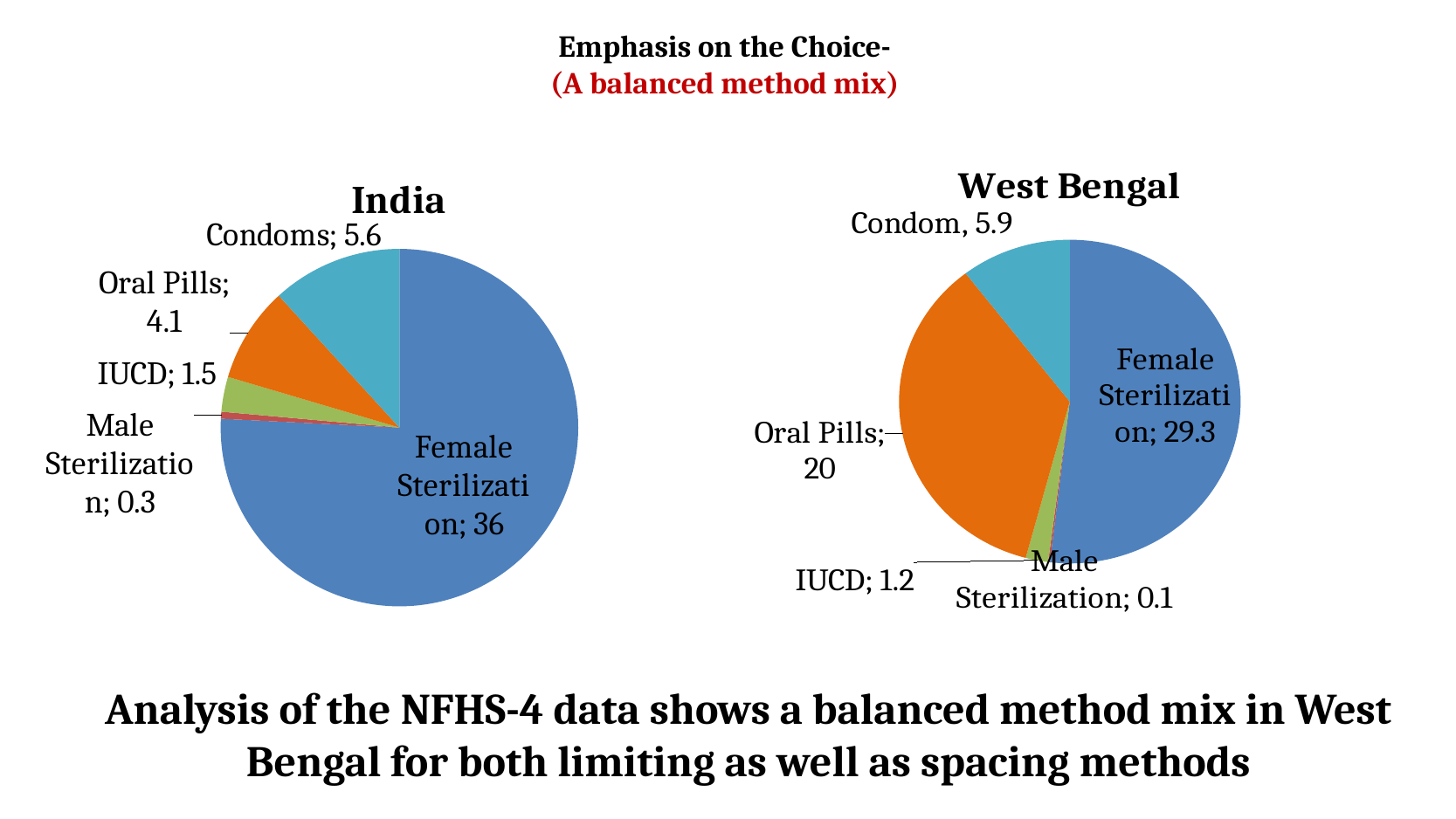
What is the title of the chart on the left? India In the India chart, what is the difference between Condoms and Oral Pills? 1.5 In the West Bengal chart, what is the difference between Female Sterilization and Oral Pills? 9.3 In the West Bengal chart, what is the value for Oral Pills? 20 In the India chart, which category has the smallest slice? Male Sterilization In the India chart, what is the value for Female Sterilization? 36 In the India chart, what is the value for Condoms? 5.6 Which is larger: Oral Pills in the India chart or Oral Pills in the West Bengal chart? West Bengal In the West Bengal chart, what is the value for IUCD? 1.2 In the West Bengal chart, which category has the largest slice? Female Sterilization How many categories are shown in the India chart? 5 What kind of chart is the West Bengal chart? Pie chart